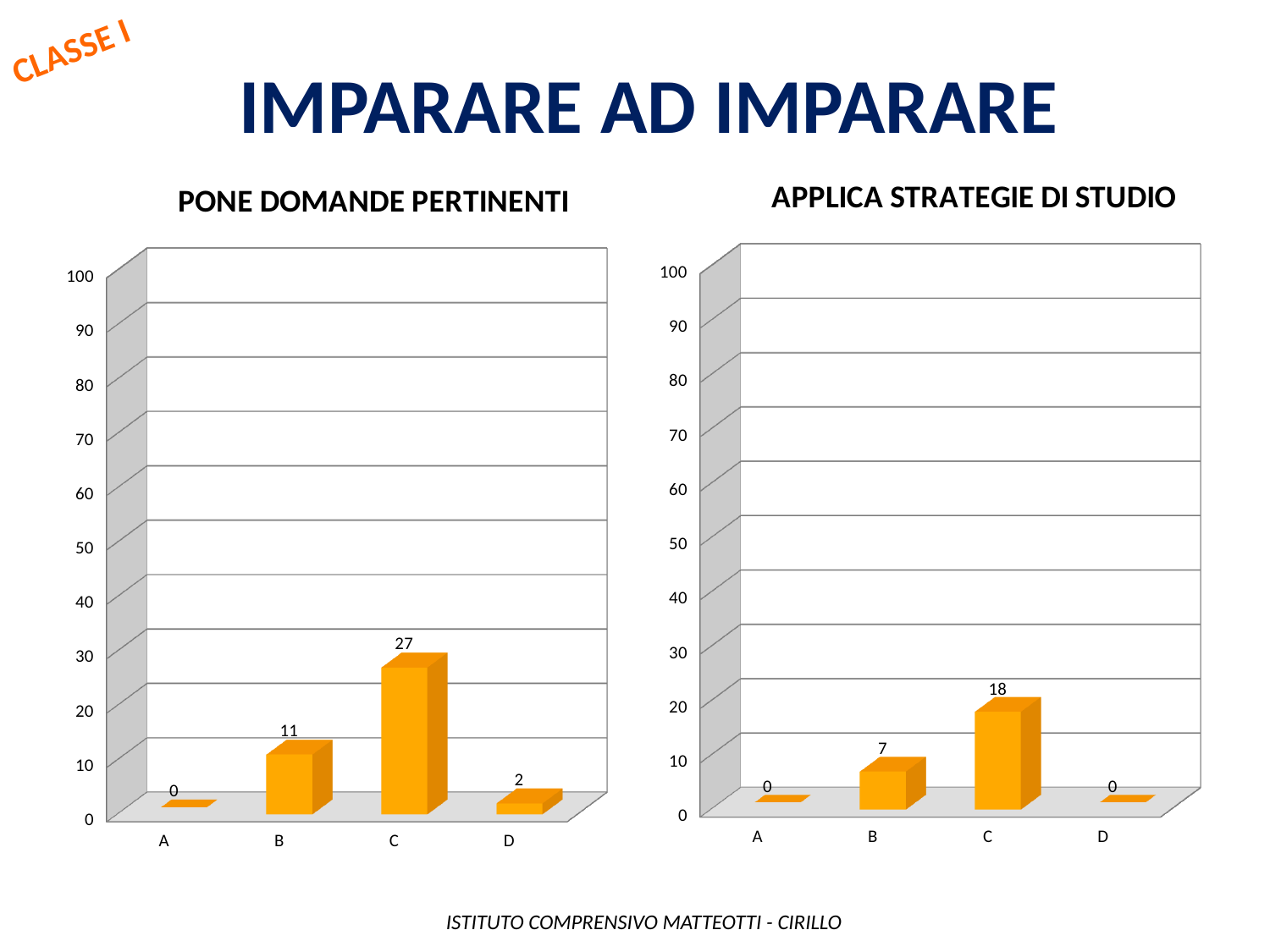
In the 'APPLICA STRATEGIE DI STUDIO' chart, what is the value for category C? 18 In the 'PONE DOMANDE PERTINENTI' chart, what is the difference between the values for C and B? 16 In the 'PONE DOMANDE PERTINENTI' chart, what is the value for category C? 27 In the 'PONE DOMANDE PERTINENTI' chart, which category has the highest value? C In the 'PONE DOMANDE PERTINENTI' chart, which category has the lowest value? A In the 'APPLICA STRATEGIE DI STUDIO' chart, what is the value for category B? 7 In the 'PONE DOMANDE PERTINENTI' chart, which is larger, the value for B or the value for D? B How many categories are shown in the 'APPLICA STRATEGIE DI STUDIO' chart? 4 In the 'APPLICA STRATEGIE DI STUDIO' chart, which category has the highest value? C In the 'APPLICA STRATEGIE DI STUDIO' chart, what is the difference between the values for C and B? 11 In the 'PONE DOMANDE PERTINENTI' chart, what is the value for category B? 11 What kind of chart is the 'PONE DOMANDE PERTINENTI' chart? Bar chart